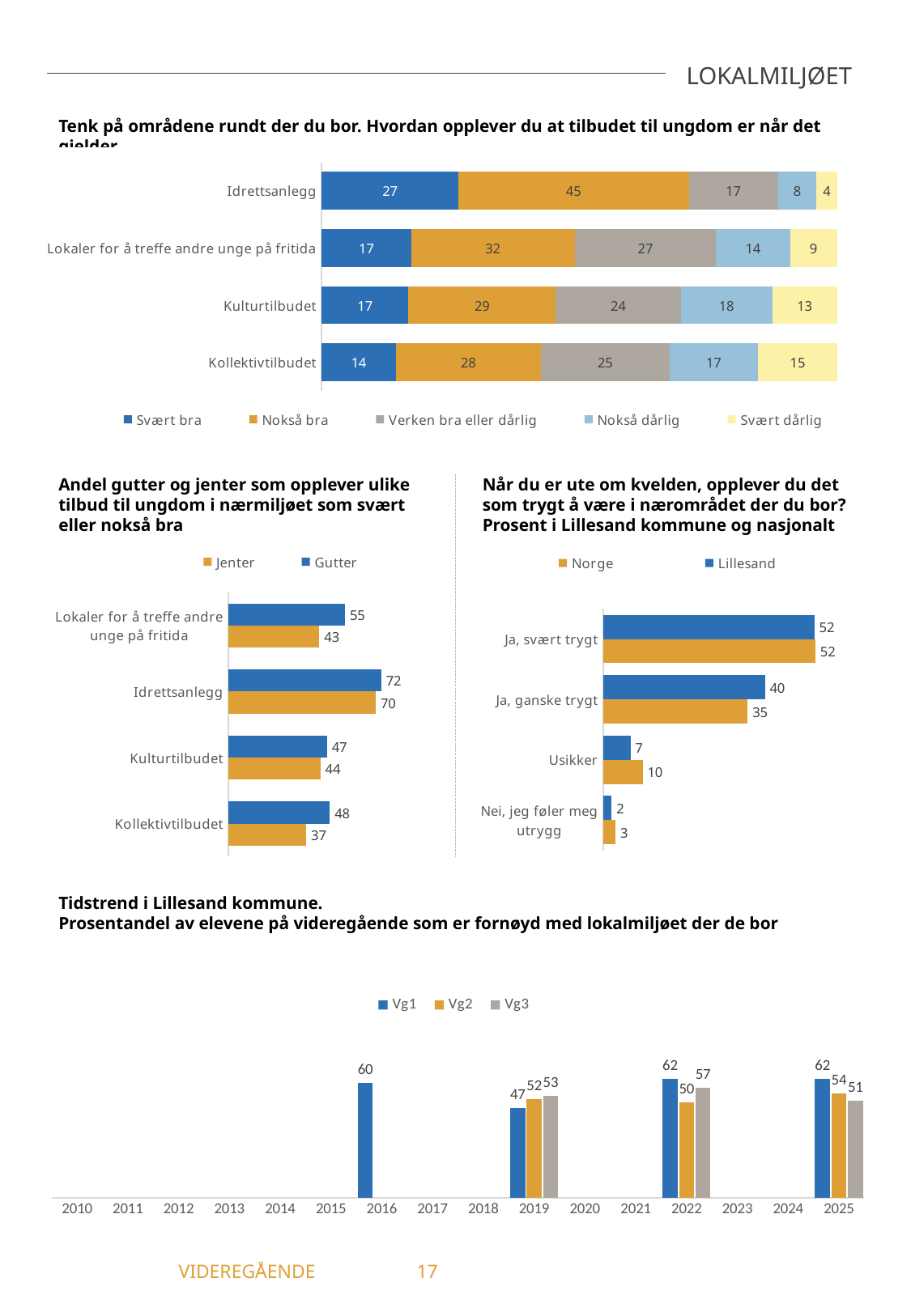
In the chart 'Når du er ute om kvelden, opplever du det som trygt å være i nærområdet der du bor?', what is the value for Norge for 'Ja, ganske trygt'? 35 In the chart 'Når du er ute om kvelden, opplever du det som trygt å være i nærområdet der du bor?', which is larger for 'Usikker': Norge or Lillesand? Norge In the top chart (Tenk på områdene rundt der du bor), how many series does the legend list? 5 In the chart 'Andel gutter og jenter som opplever ulike tilbud til ungdom i nærmiljøet som svært eller nokså bra', what is the value for Jenter for Kollektivtilbudet? 37 What kind of chart is the 'Tidstrend i Lillesand kommune' chart? Bar chart In the top chart (Tenk på områdene rundt der du bor), what is the value for 'Svært bra' for Idrettsanlegg? 27 In the chart 'Andel gutter og jenter som opplever ulike tilbud til ungdom i nærmiljøet som svært eller nokså bra', what is the difference between Gutter and Jenter for Lokaler for å treffe andre unge på fritida? 12 In the chart 'Tidstrend i Lillesand kommune', what is the value for Vg3 in 2022? 57 In the chart 'Andel gutter og jenter som opplever ulike tilbud til ungdom i nærmiljøet som svært eller nokså bra', which category has the highest value for Gutter? Idrettsanlegg In the chart 'Tidstrend i Lillesand kommune', how many series does the legend list? 3 In the top chart (Tenk på områdene rundt der du bor), which category has the highest 'Svært dårlig' value? Kollektivtilbudet In the top chart (Tenk på områdene rundt der du bor), what is the total of the stacked bar for Kulturtilbudet? 101